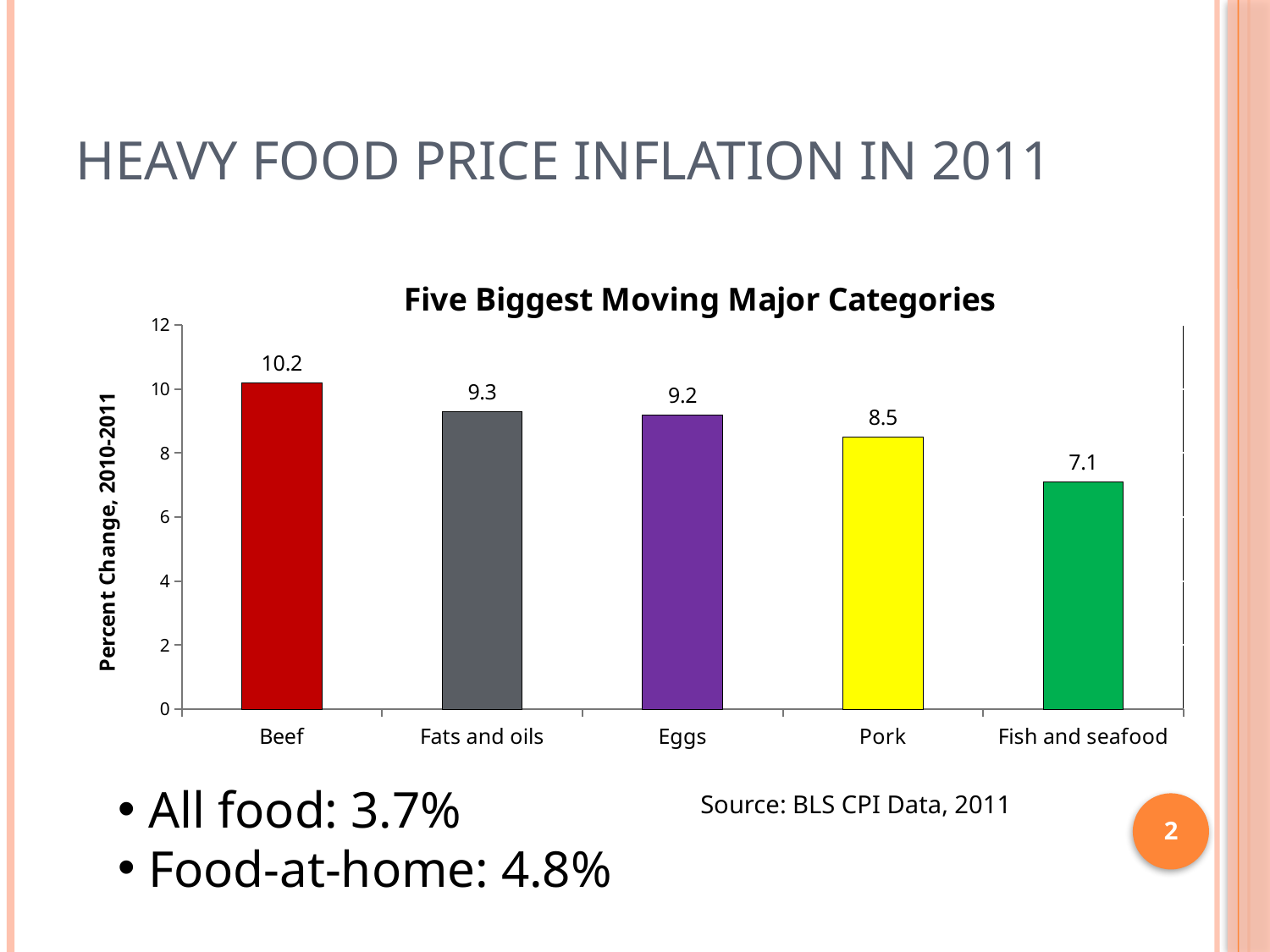
Which category has the lowest percent change? Fish and seafood How many categories are shown in the chart? 5 What kind of chart is shown on the slide? bar chart What is the difference between the percent change for Beef and for Fish and seafood? 3.1 What is the percent change for Beef? 10.2 What is the percent change for Fish and seafood? 7.1 What is the difference between the percent change for Fats and oils and for Pork? 0.8 What is the title of the chart? Five Biggest Moving Major Categories What is the percent change for Pork? 8.5 Which category has the highest percent change? Beef Is the value for Fish and seafood greater or less than 8? less Which has a larger percent change, Eggs or Pork? Eggs